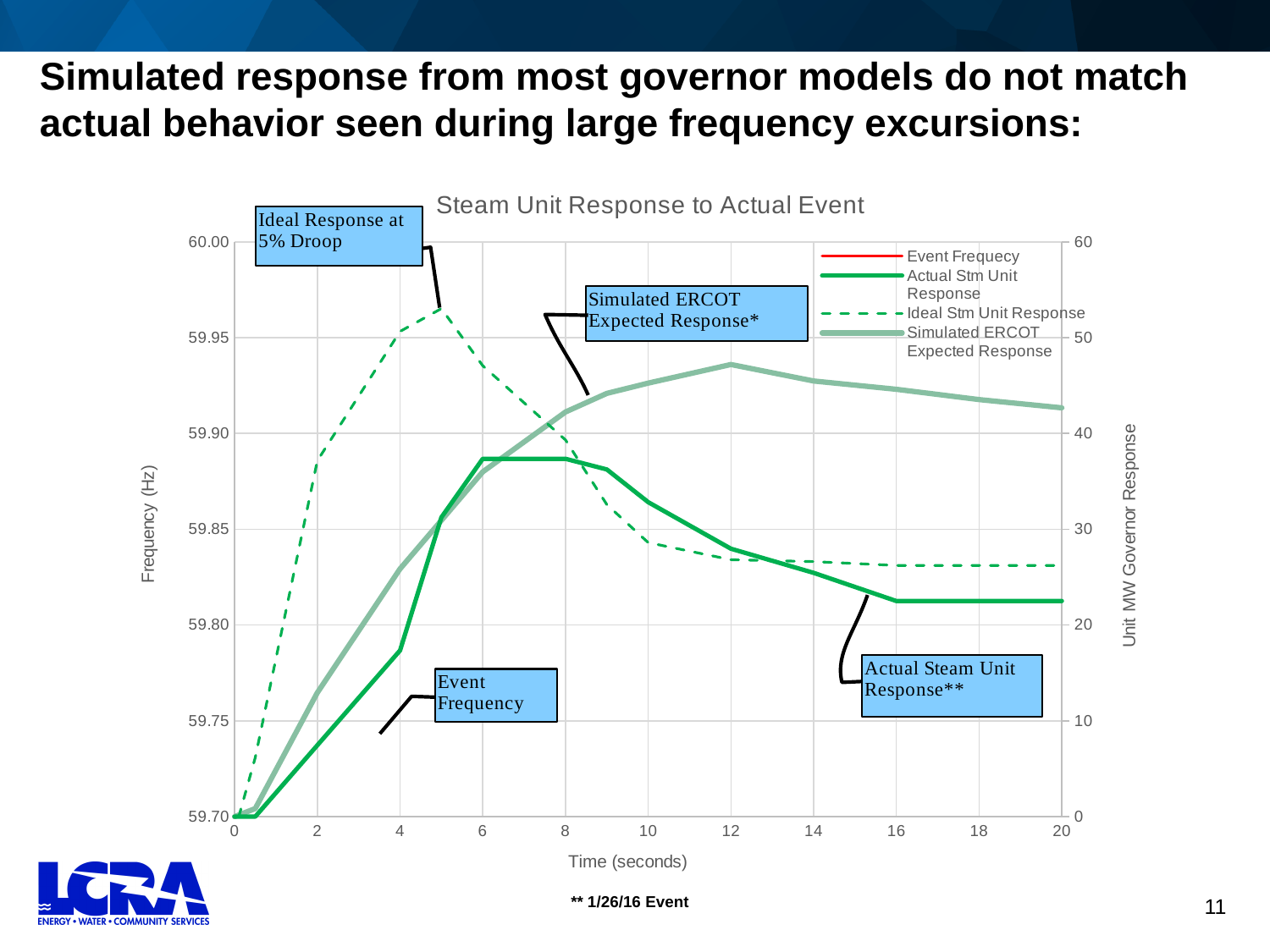
Is the peak value of the Ideal Stm Unit Response series greater or less than 50 on the right axis? greater Does the Simulated ERCOT Expected Response rise or fall between 12 and 20 seconds? fall What is the label of the x axis? Time (seconds) Is the Simulated ERCOT Expected Response at 12 seconds greater or less than 40 on the right axis? greater Is the Actual Stm Unit Response at 20 seconds greater or less than 20 on the right axis? greater How many series does the chart legend list? 4 At 12 seconds, which is larger: the Simulated ERCOT Expected Response or the Actual Stm Unit Response? Simulated ERCOT Expected Response What kind of chart is shown on the slide? line chart Which series reaches the highest peak value on the chart? Ideal Stm Unit Response Which series has the lowest value at 20 seconds? Actual Stm Unit Response What is the title of the chart? Steam Unit Response to Actual Event